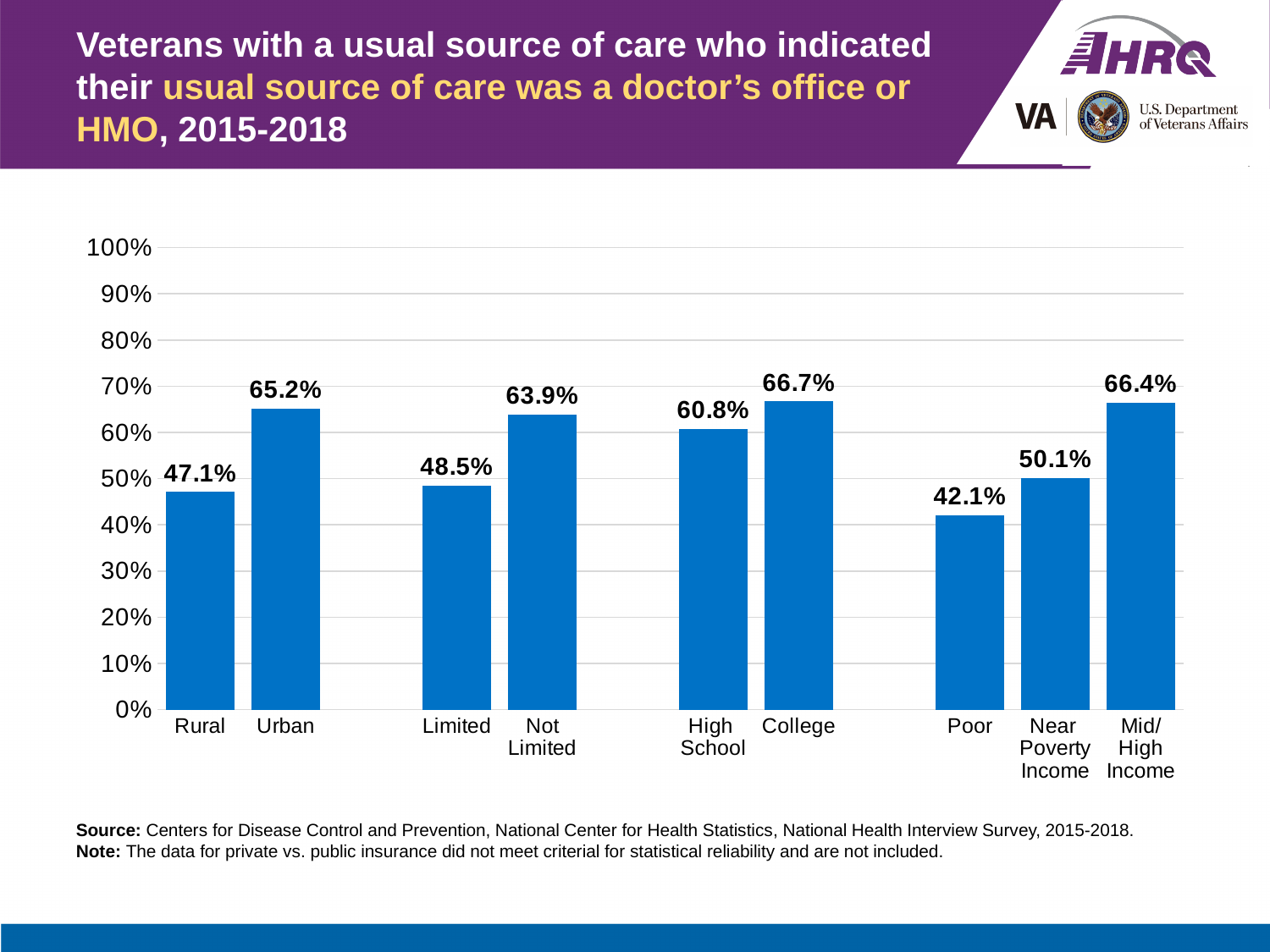
Is the value for Mid/High Income greater or less than 60%? greater What years does the chart title say the data cover? 2015-2018 What is the difference between the values for College and High School? 5.9% What is the value for Rural? 47.1% What kind of chart is shown on the slide? Bar chart What is the value for Near Poverty Income? 50.1% What is the value for Not Limited? 63.9% Which category has the lowest value? Poor What is the difference between the values for Urban and Rural? 18.1% How many categories are shown on the x axis? 9 Which is larger, the value for Limited or the value for Near Poverty Income? Near Poverty Income Which category has the highest value? College